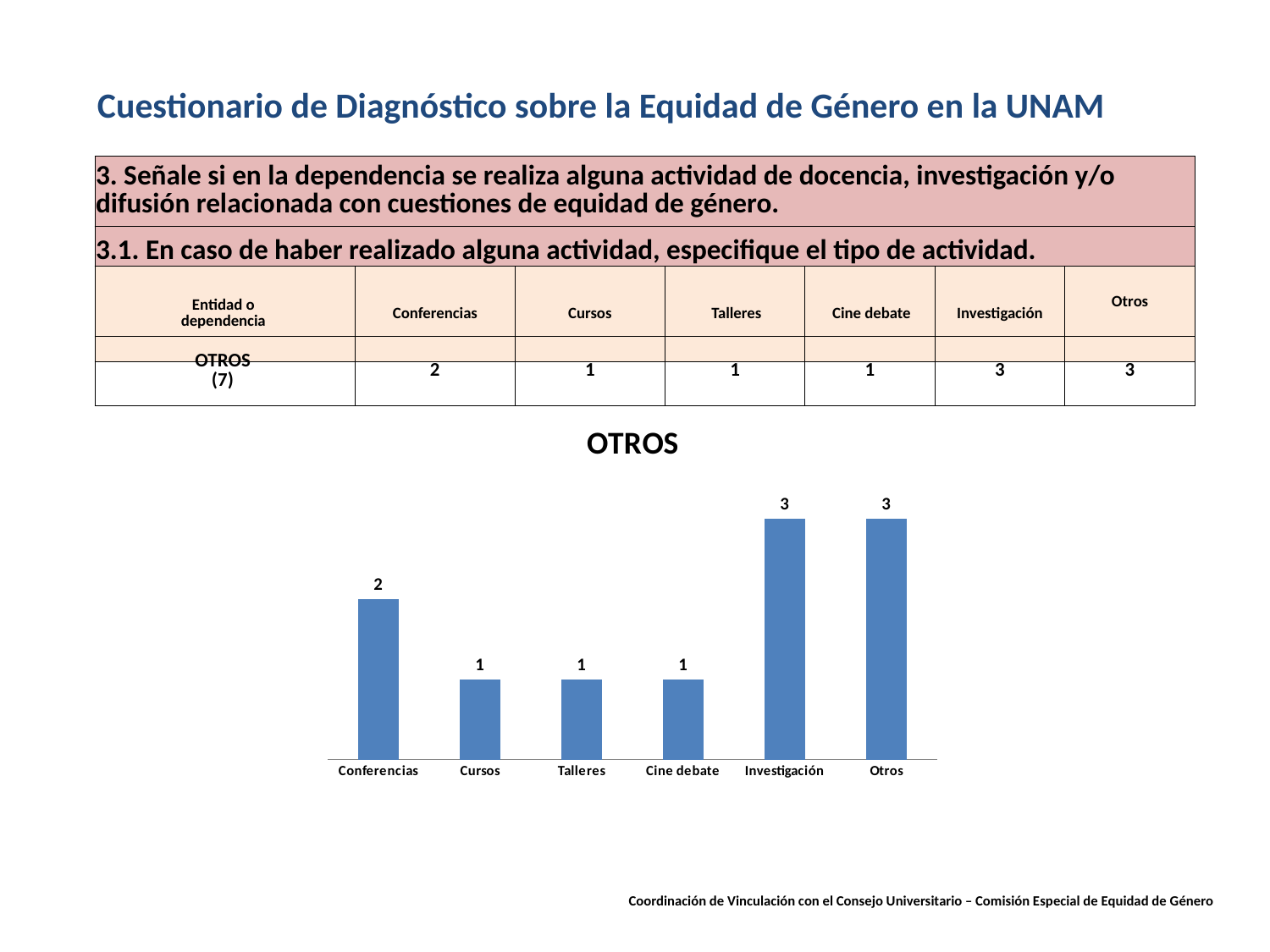
What is the value for Investigación in the OTROS chart? 3 What is the value for Cine debate in the OTROS chart? 1 Which categories have the highest value in the OTROS chart? Investigación and Otros Which category has the lowest value in the OTROS chart, Conferencias or Cursos? Cursos What is the total of all the values shown in the OTROS chart? 11 What is the difference between the values for Conferencias and Cursos in the OTROS chart? 1 What is the difference between the values for Investigación and Conferencias in the OTROS chart? 1 How many categories are shown on the x axis of the OTROS chart? 6 What is the title of the chart on the slide? OTROS What is the value for Conferencias in the OTROS chart? 2 What kind of chart is shown on the slide? Bar chart Which is larger in the OTROS chart, the value for Conferencias or the value for Talleres? Conferencias